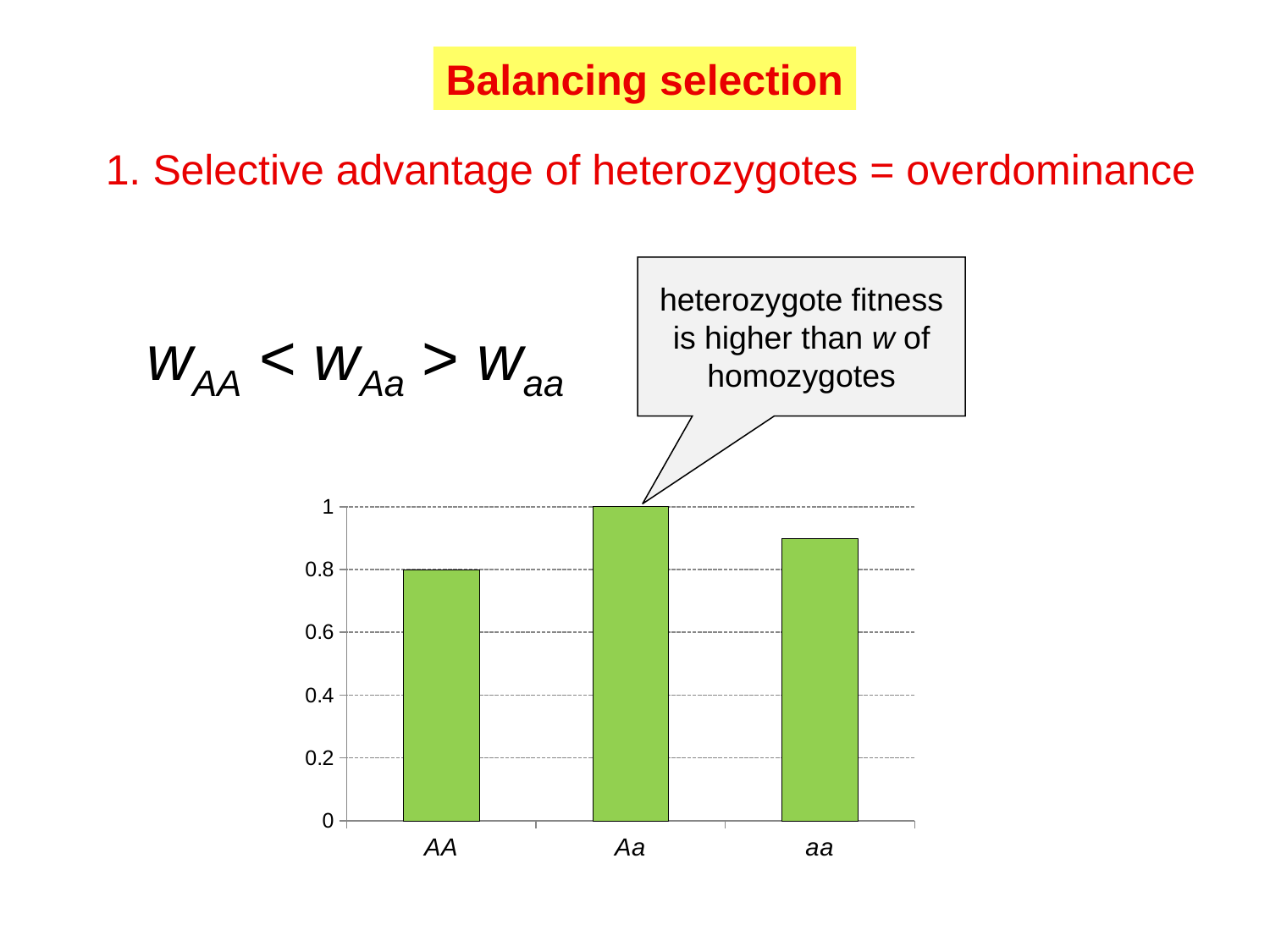
Which bar is taller, Aa or aa? Aa What is the difference between the bars for Aa and AA? 0.2 How many genotype categories are plotted on the x axis? 3 Is the value for aa greater or less than 1? less What is the value of the bar for AA? 0.8 Which genotype has the lowest bar? AA Which genotype has the highest bar? Aa What type of chart is shown on the slide? bar chart Is the value for aa greater or less than 0.8? greater What colour are the bars in the chart? green